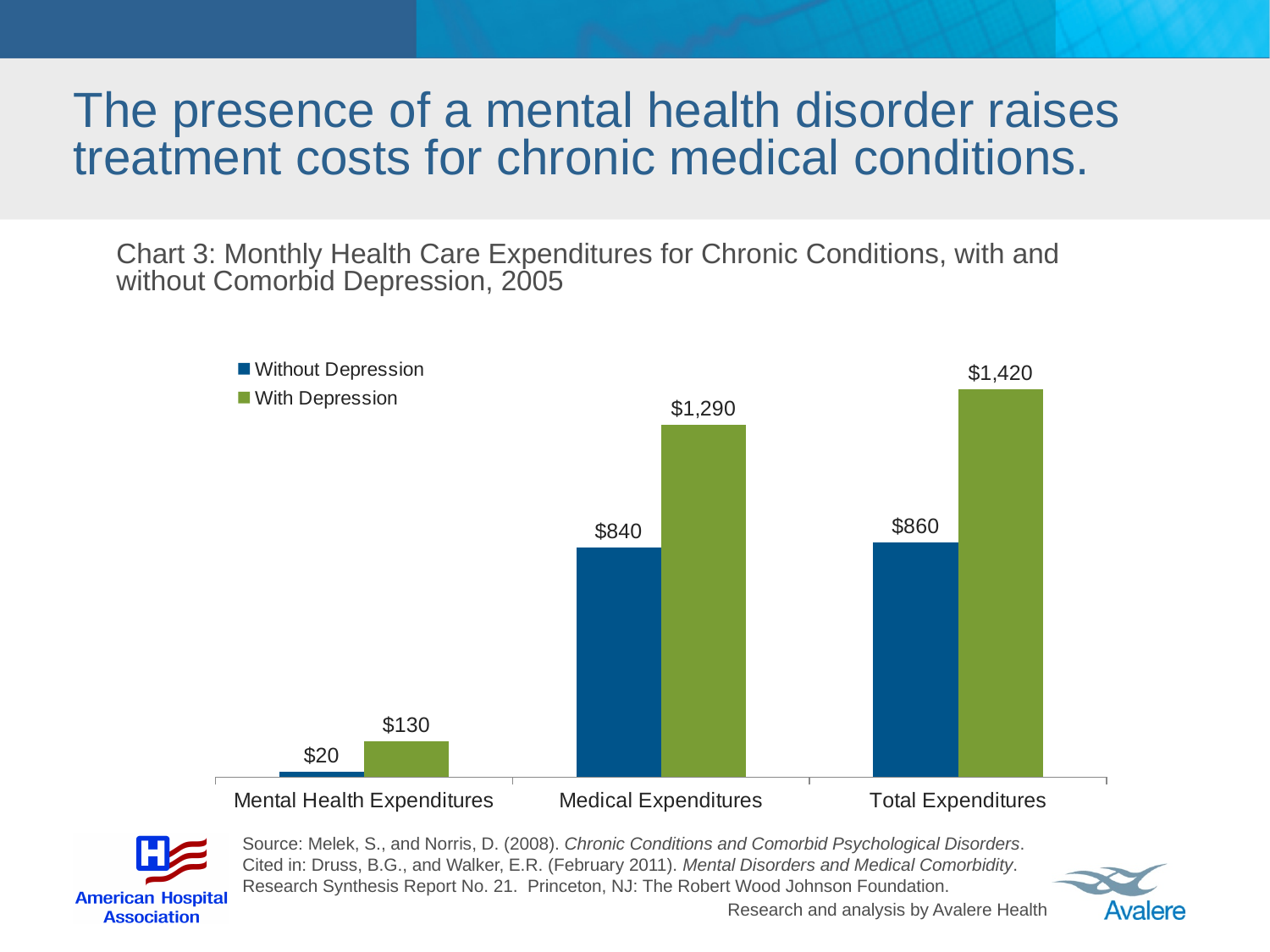
What is the difference between the With Depression and Without Depression values for Medical Expenditures? $450 Which category has the highest value in the With Depression series? Total Expenditures Which category has the lowest value in the Without Depression series? Mental Health Expenditures How many series does the legend list? 2 Which is larger: the Without Depression value for Medical Expenditures or the Without Depression value for Total Expenditures? Total Expenditures What kind of chart is shown on the slide? Bar chart What is the value for Mental Health Expenditures in the With Depression series? $130 What is the value for Total Expenditures in the Without Depression series? $860 How many categories are shown on the x axis? 3 What is the value for Mental Health Expenditures in the Without Depression series? $20 What is the difference between the With Depression and Without Depression values for Total Expenditures? $560 What is the value for Medical Expenditures in the With Depression series? $1,290